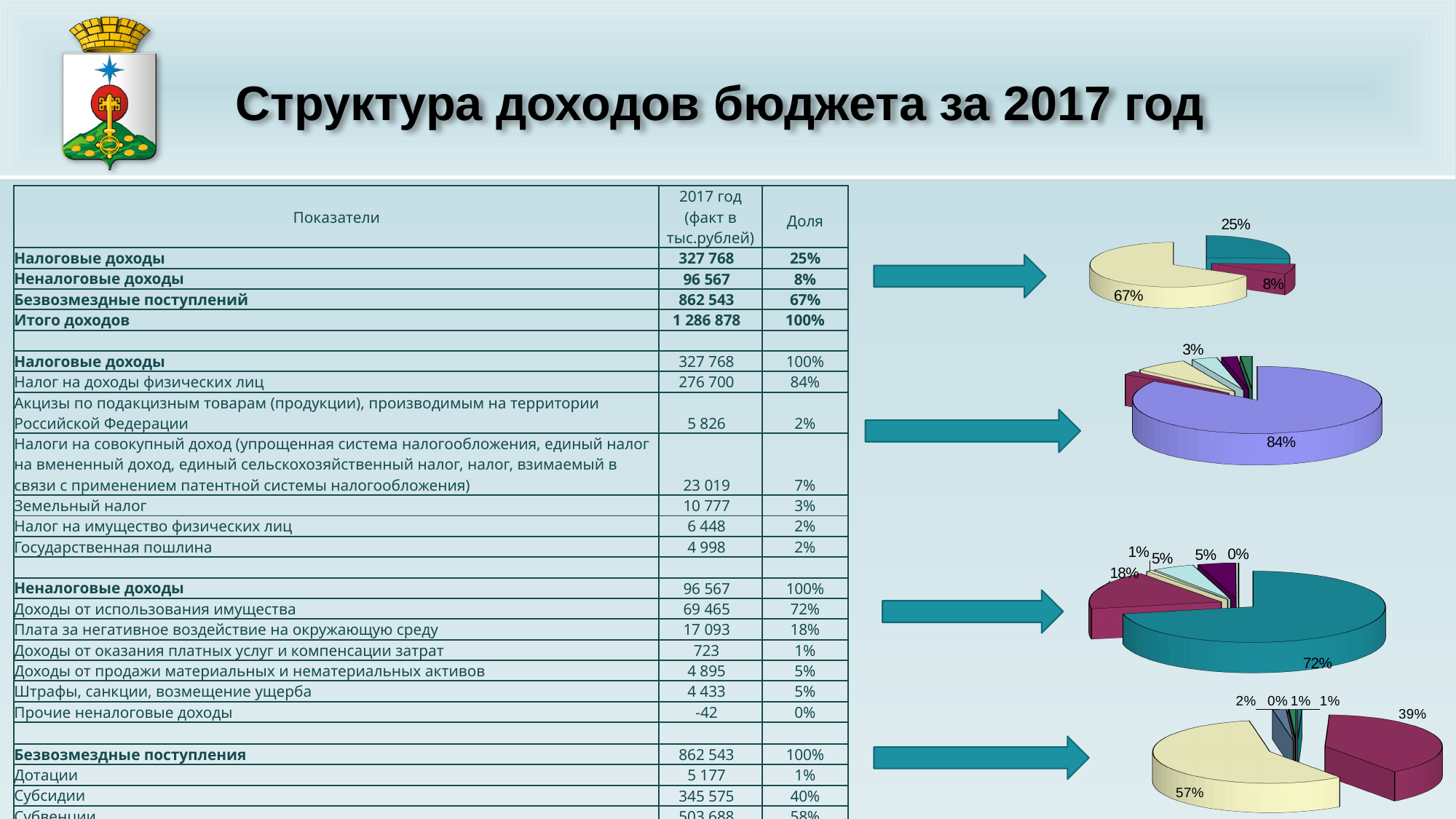
In the third pie chart from the top, what is the label of the second-largest slice? 18% In the second pie chart from the top, what is the label of the largest slice? 84% In the top pie chart, how many slices are there? 3 In the third pie chart from the top, what is the label of the largest slice? 72% In the bottom pie chart, what is the label of the largest slice? 57% What kind of chart is shown at the top right of the slide? Pie chart In the top pie chart, what is the label of the smallest slice? 8% How many pie charts are shown on the slide? 4 In the top pie chart, what is the difference between the 67% slice and the 25% slice? 42 percentage points In the bottom pie chart, which slice is larger, the one labelled 57% or the one labelled 39%? 57% In the top pie chart, which slice is larger, the teal one or the magenta one? The teal one (25%)